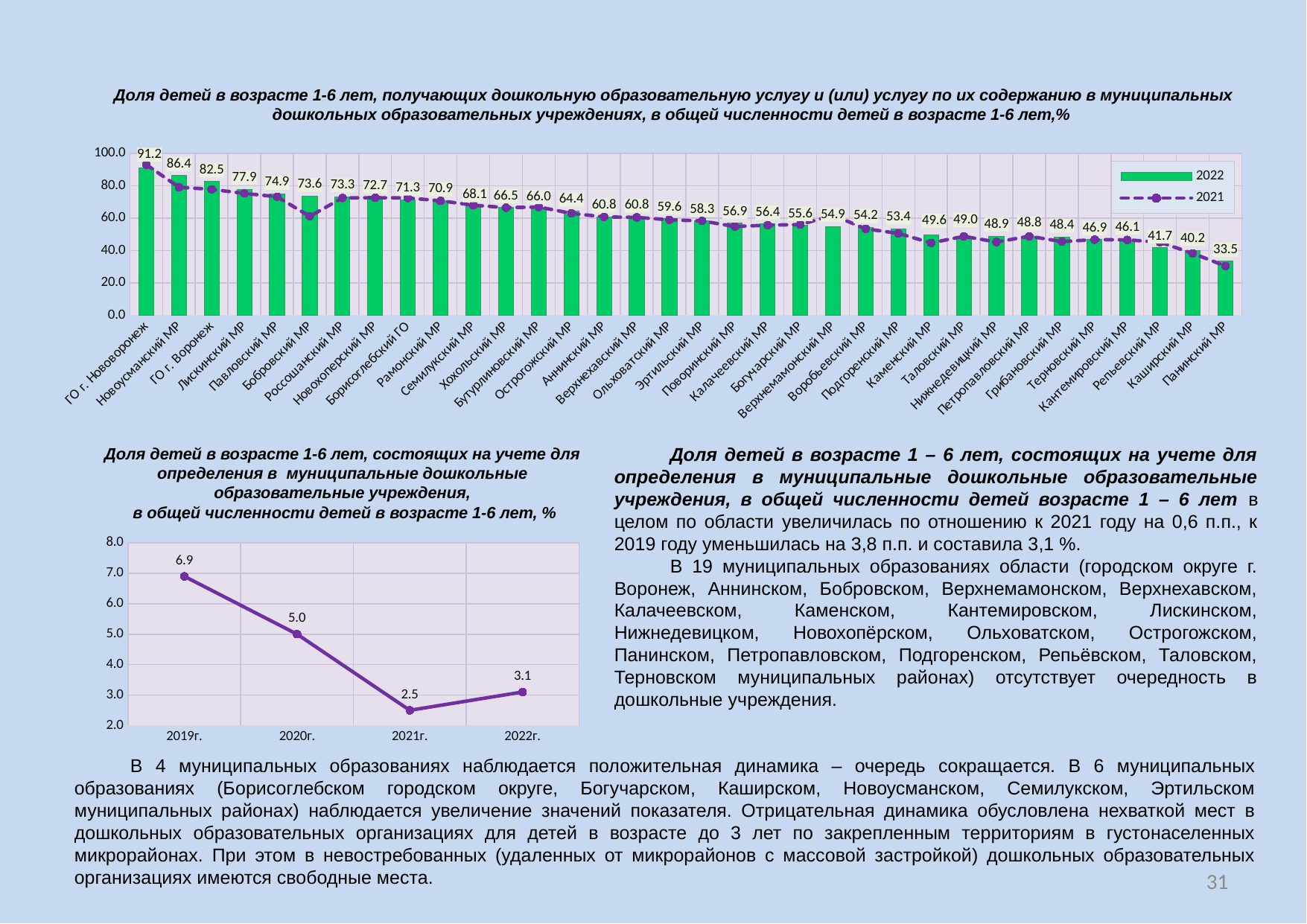
In the top chart, what is the difference between the 2022 values for ГО г. Воронеж and Лискинский МР? 4.6 In the top chart, how many series does the legend list? 2 In the top chart, which category has the highest 2022 value? ГО г. Нововоронеж In the top chart, what is the 2022 value for ГО г. Нововоронеж? 91.2 In the bottom-left chart, what is the value for 2021г.? 2.5 In the top chart, which category has the lowest 2022 value? Панинский МР In the top chart, what is the 2022 value for Бобровский МР? 73.6 In the bottom-left chart, what is the difference between the values for 2019г. and 2022г.? 3.8 In the top chart, is the 2021 value for Бобровский МР greater or less than 80.0? less What type of chart is the bottom-left chart? line chart In the bottom-left chart, how many data points are plotted? 4 In the top chart, which has a larger 2022 value, Каширский МР or Репьевский МР? Репьевский МР